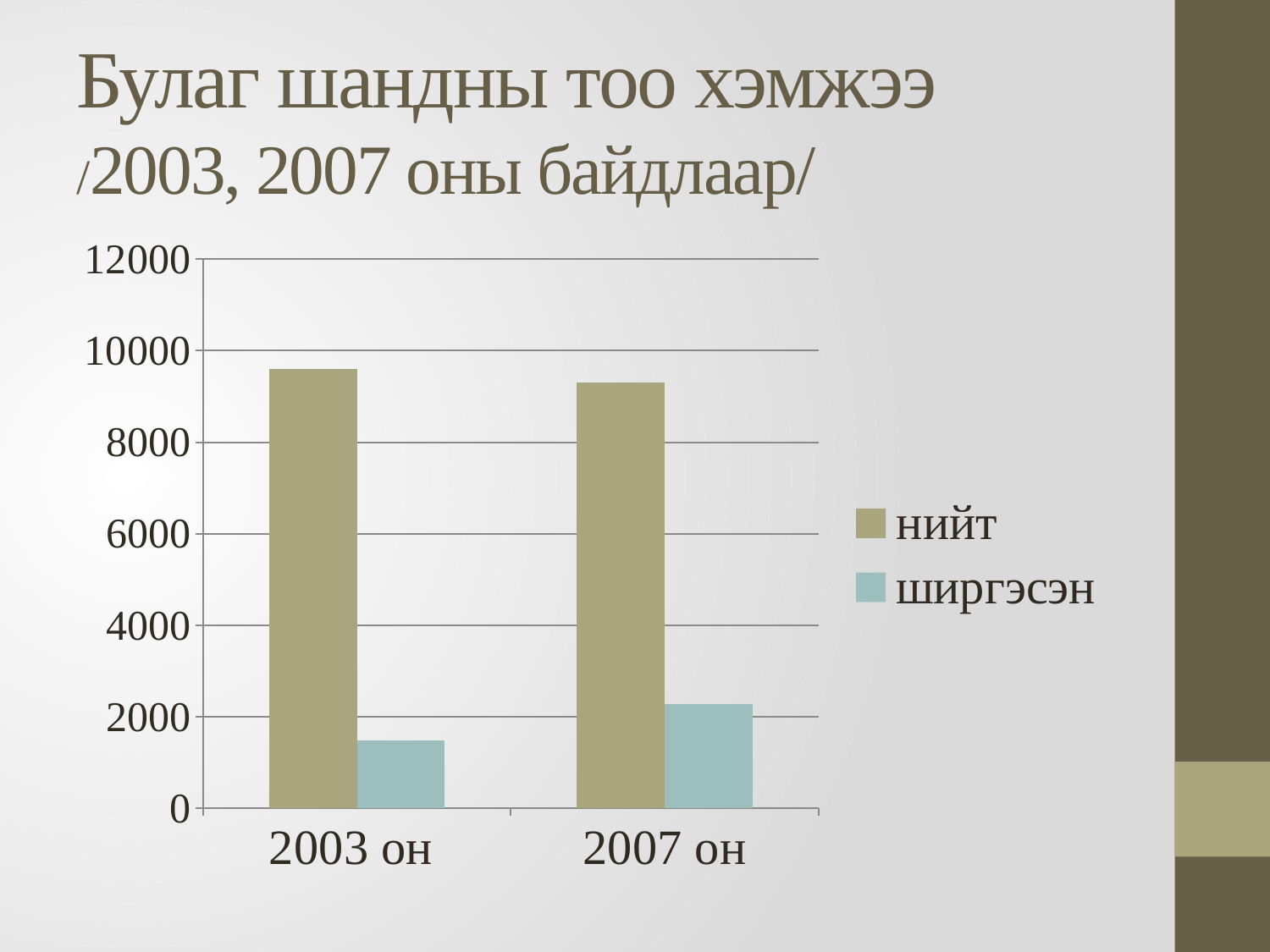
Is the value for ширгэсэн in 2007 он greater or less than 2000? greater Is the value for нийт in 2003 он greater or less than 8000? greater Does the ширгэсэн series rise or fall from 2003 он to 2007 он? rise In 2007 он, which series has the lowest value? ширгэсэн What is the title of the chart on the slide? Булаг шандны тоо хэмжээ /2003, 2007 оны байдлаар/ Which is larger, the ширгэсэн value for 2003 он or for 2007 он? 2007 он Is the value for нийт in 2007 он greater or less than 10000? less Which series does the legend list first? нийт What kind of chart is shown on the slide? bar chart How many series does the legend list? 2 How many categories are shown on the x axis? 2